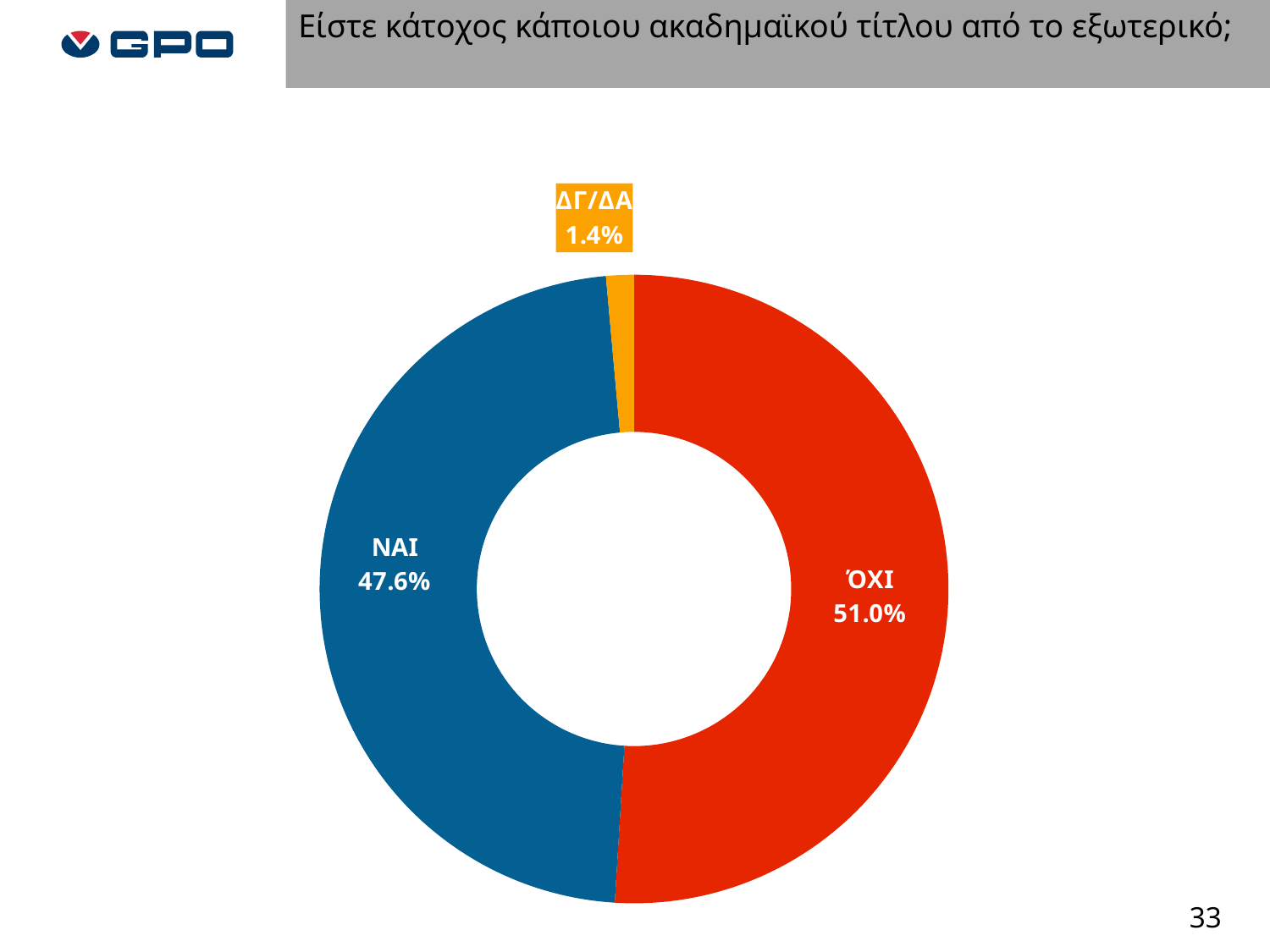
How many categories are shown in the chart? 3 What kind of chart is shown on the slide? Doughnut (pie) chart What is the combined share of ΝΑΙ and ΌΧΙ? 98.6% What is the value shown for ΔΓ/ΔΑ? 1.4% Which category has the largest share of the chart? ΌΧΙ What question is shown as the title of the slide? Είστε κάτοχος κάποιου ακαδημαϊκού τίτλου από το εξωτερικό; What colour is the ΝΑΙ segment of the chart? Blue What is the difference in percentage points between ΌΧΙ and ΝΑΙ? 3.4 Which is larger, the share for ΝΑΙ or the share for ΌΧΙ? ΌΧΙ What percentage of respondents answered ΌΧΙ? 51.0% What percentage of respondents answered ΝΑΙ? 47.6% Which category has the smallest share of the chart? ΔΓ/ΔΑ